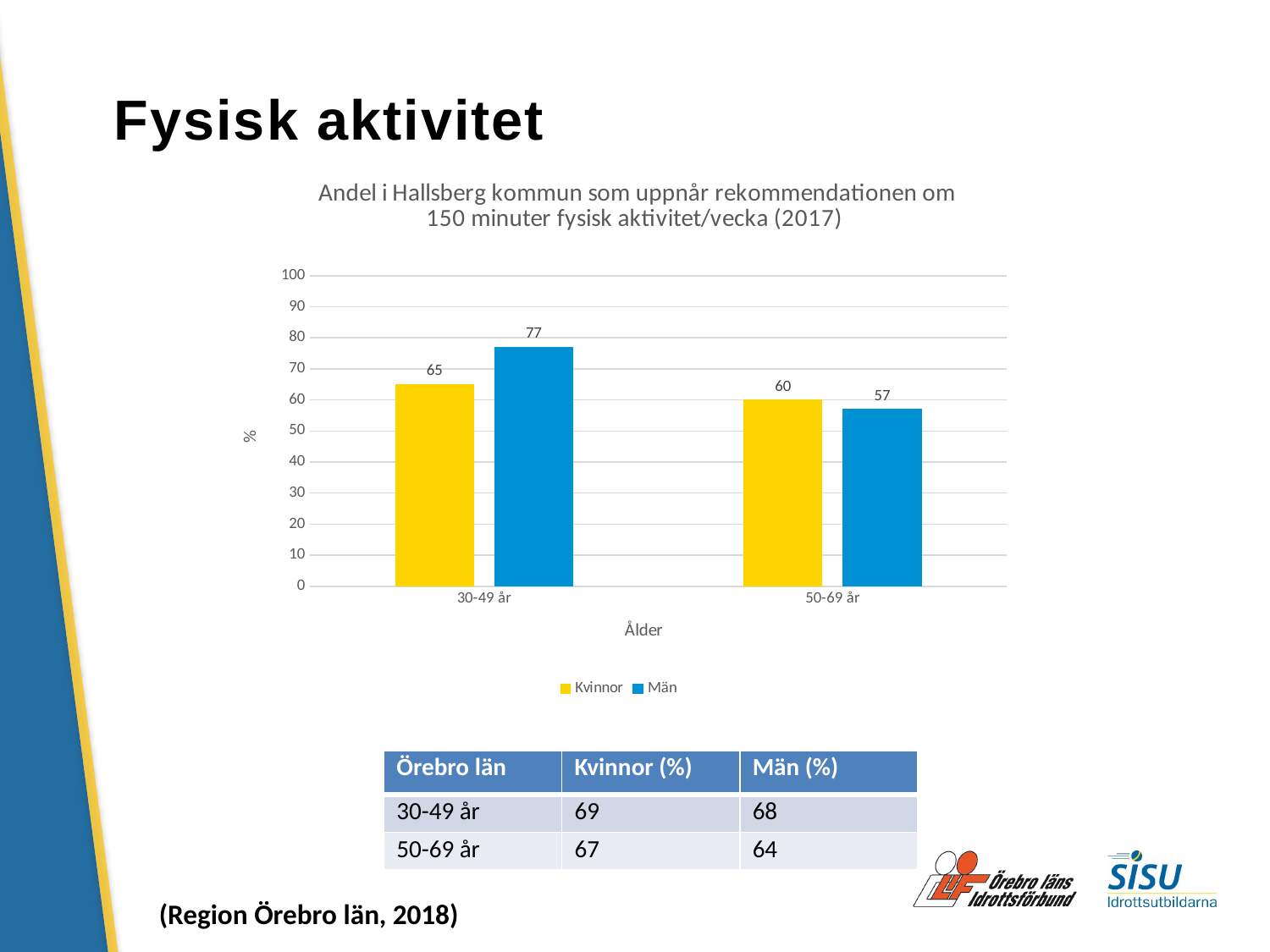
What is the label of the x axis? Ålder What is the value for Män in the 30-49 år age group? 77 Which bar has the highest value in the chart? Män, 30-49 år How many age groups are shown on the x axis? 2 What is the value for Kvinnor in the 30-49 år age group? 65 What is the value for Kvinnor in the 50-69 år age group? 60 Which is larger in the 50-69 år age group, Kvinnor or Män? Kvinnor What is the value for Män in the 50-69 år age group? 57 What kind of chart is shown on the slide? Bar chart Which bar has the lowest value in the chart? Män, 50-69 år How many series does the legend list? 2 What is the difference between Män and Kvinnor in the 30-49 år age group? 12